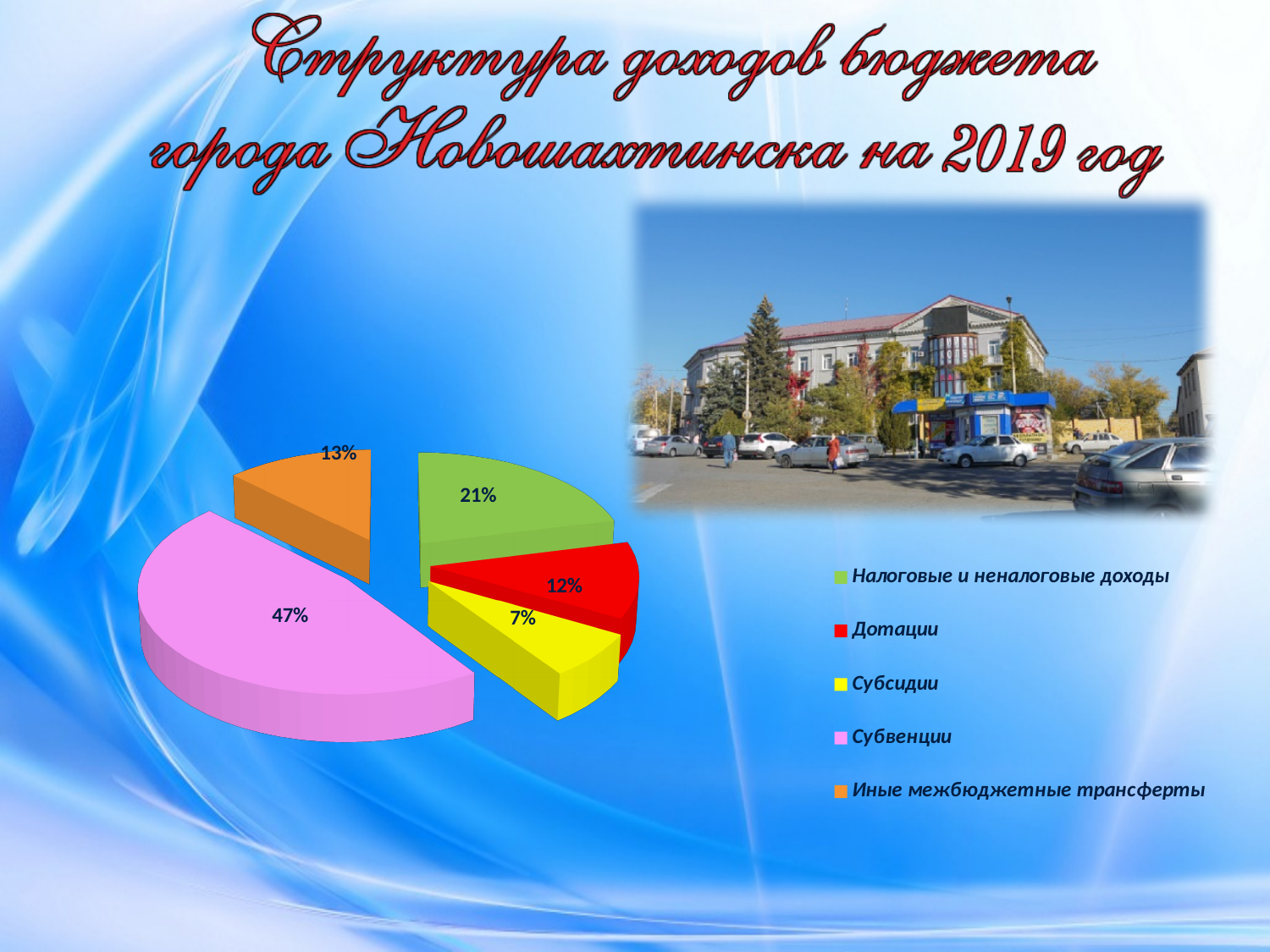
What kind of chart is shown on the slide? Pie chart What share of the pie does Субвенции have? 47% What is the difference between the shares of Субвенции and Налоговые и неналоговые доходы? 26% How many categories does the pie chart have? 5 What is the value shown for Налоговые и неналоговые доходы? 21% Which colour represents Субвенции in the legend? Pink What is the value shown for Субсидии? 7% Which category has the smallest share of the pie? Субсидии What is the value shown for Дотации? 12% Which is larger, the share of Дотации or the share of Иные межбюджетные трансферты? Иные межбюджетные трансферты Which category has the largest share of the pie? Субвенции What is the value shown for Иные межбюджетные трансферты? 13%